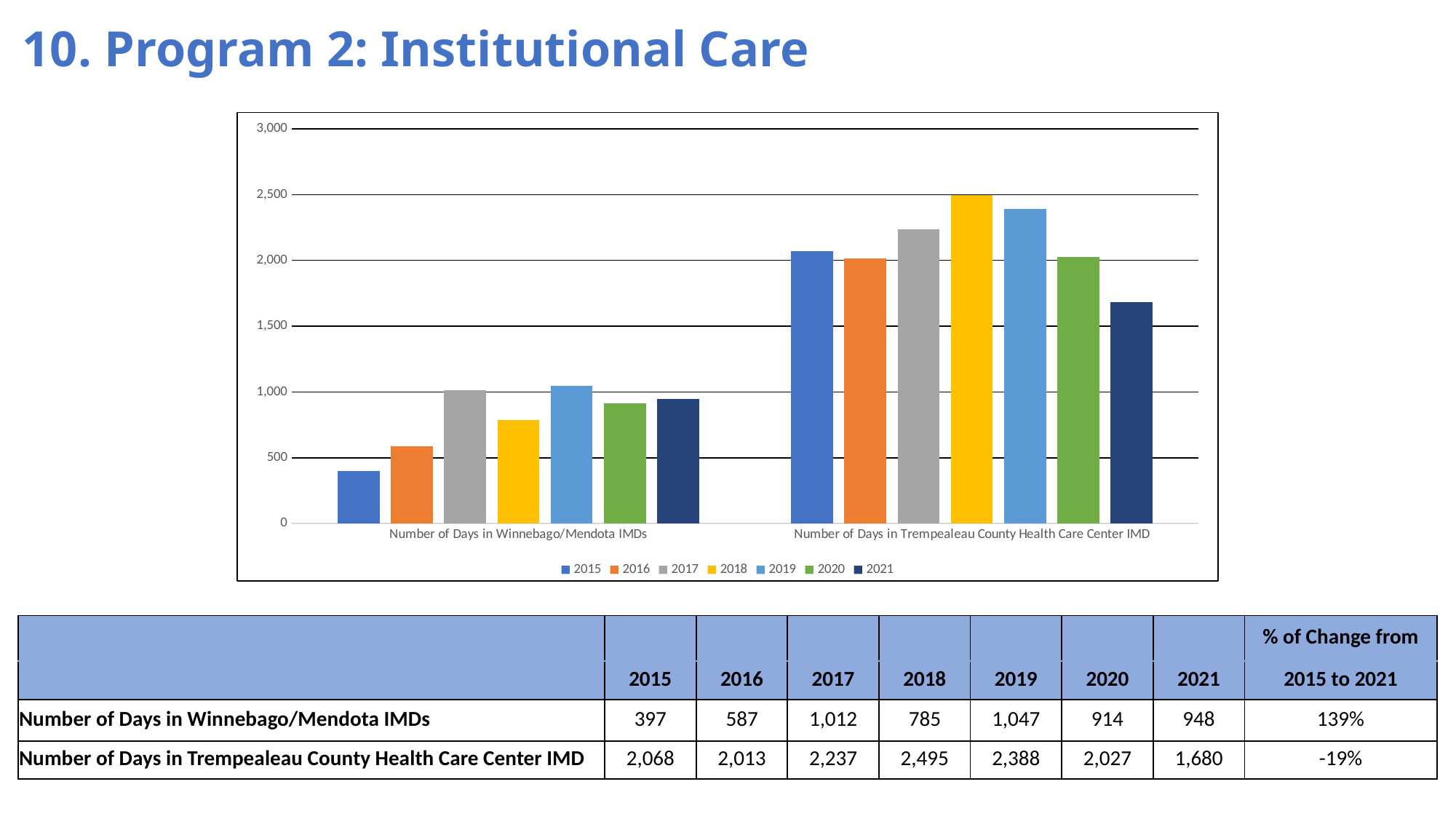
Which is larger: the number of days in Trempealeau County Health Care Center IMD in 2019 or in 2020? 2019 What is the number of days in Trempealeau County Health Care Center IMD in 2018? 2,495 How many categories are shown on the x axis of the chart? 2 What kind of chart is shown on the slide? bar chart Is the number of days in Trempealeau County Health Care Center IMD in 2021 greater or less than 2,000? less Which year has the lowest number of days in Winnebago/Mendota IMDs? 2015 Which colour represents 2018 in the chart legend? yellow What is the number of days in Winnebago/Mendota IMDs in 2015? 397 How many series does the chart legend list? 7 What is the difference between the number of days in Winnebago/Mendota IMDs in 2021 and in 2015? 551 What is the percent change from 2015 to 2021 for the number of days in Winnebago/Mendota IMDs? 139% Which year has the highest number of days in Trempealeau County Health Care Center IMD? 2018